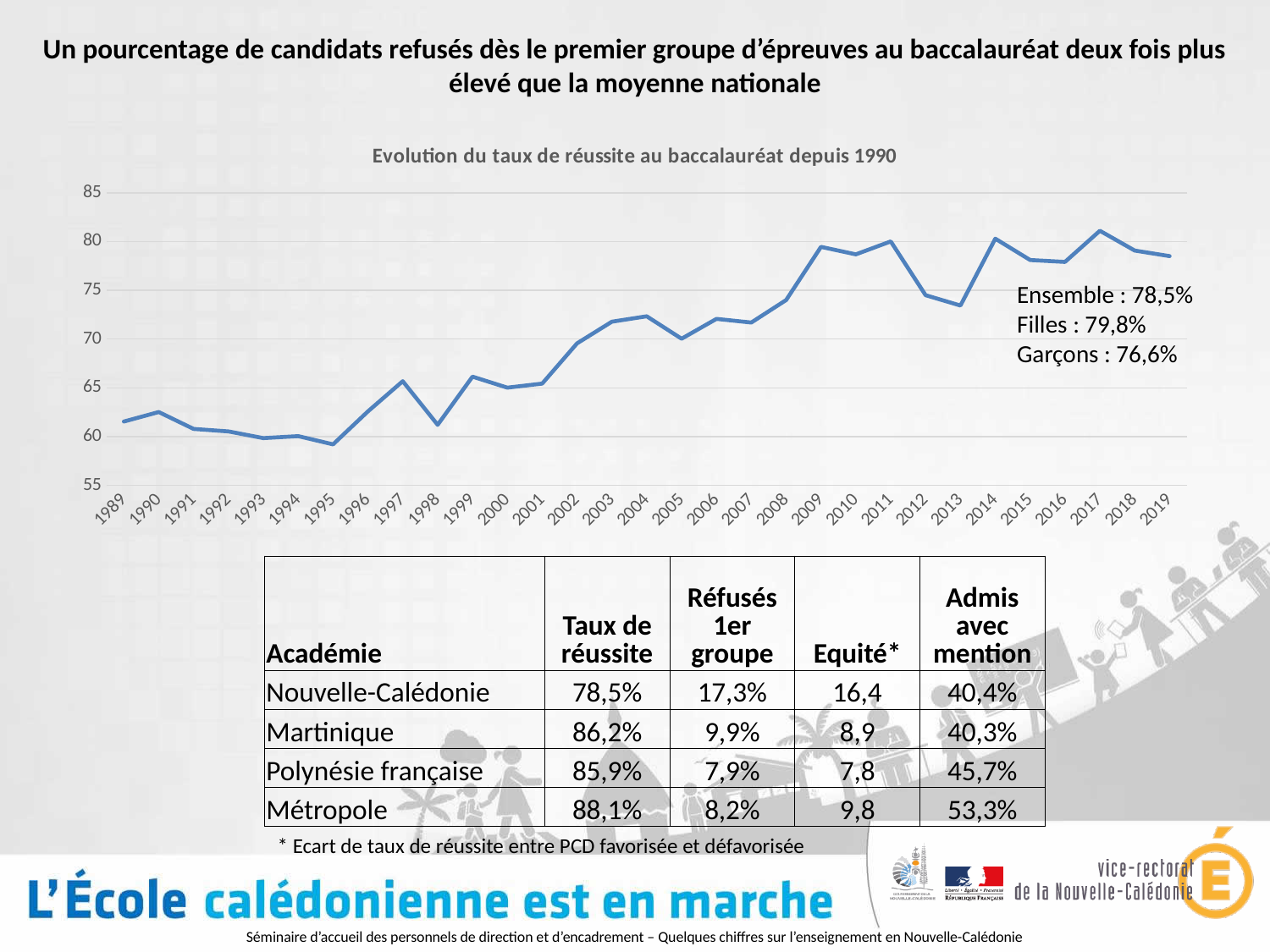
Is the value for 2009 greater or less than 75? greater Is the value for 1998 greater or less than 65? less What kind of chart is shown on the slide? line chart Is the value for 1995 greater or less than 60? less Which year has the highest success rate on the chart? 2017 How many years are shown on the x axis of the chart? 31 Which year has the higher success rate, 2009 or 2012? 2009 Overall, does the success rate rise or fall from 1989 to 2019? rise What is the title of the chart? Evolution du taux de réussite au baccalauréat depuis 1990 Which year has the higher success rate, 1997 or 1998? 1997